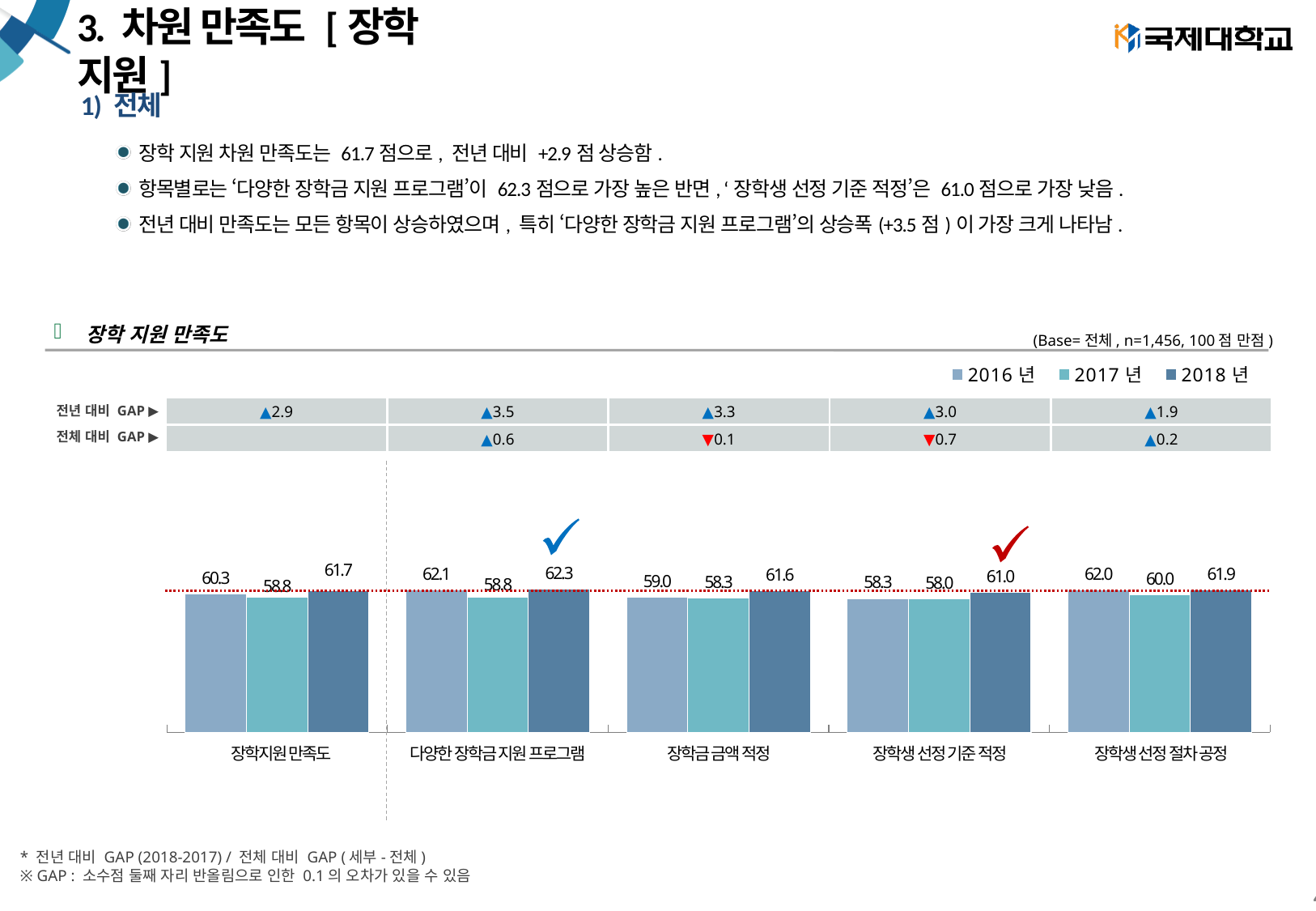
How many categories are shown on the x axis of the chart? 5 For 장학생 선정 기준 적정, do the values rise or fall from 2017년 to 2018년? rise What is the 2018년 value for 장학지원 만족도? 61.7 What kind of chart is shown on the slide? bar chart Which category has the lowest 2018년 value? 장학생 선정 기준 적정 What is the 2016년 value for 장학생 선정 절차 공정? 62.0 What is the 2017년 value for 장학금 금액 적정? 58.3 What is the 전년 대비 GAP shown for 장학금 금액 적정? ▲3.3 Which category has the highest 2018년 value? 다양한 장학금 지원 프로그램 What is the difference between the 2018년 and 2017년 values for 다양한 장학금 지원 프로그램? 3.5 How many series does the legend list? 3 Which is larger for 장학생 선정 절차 공정: the 2016년 value or the 2017년 value? 2016년